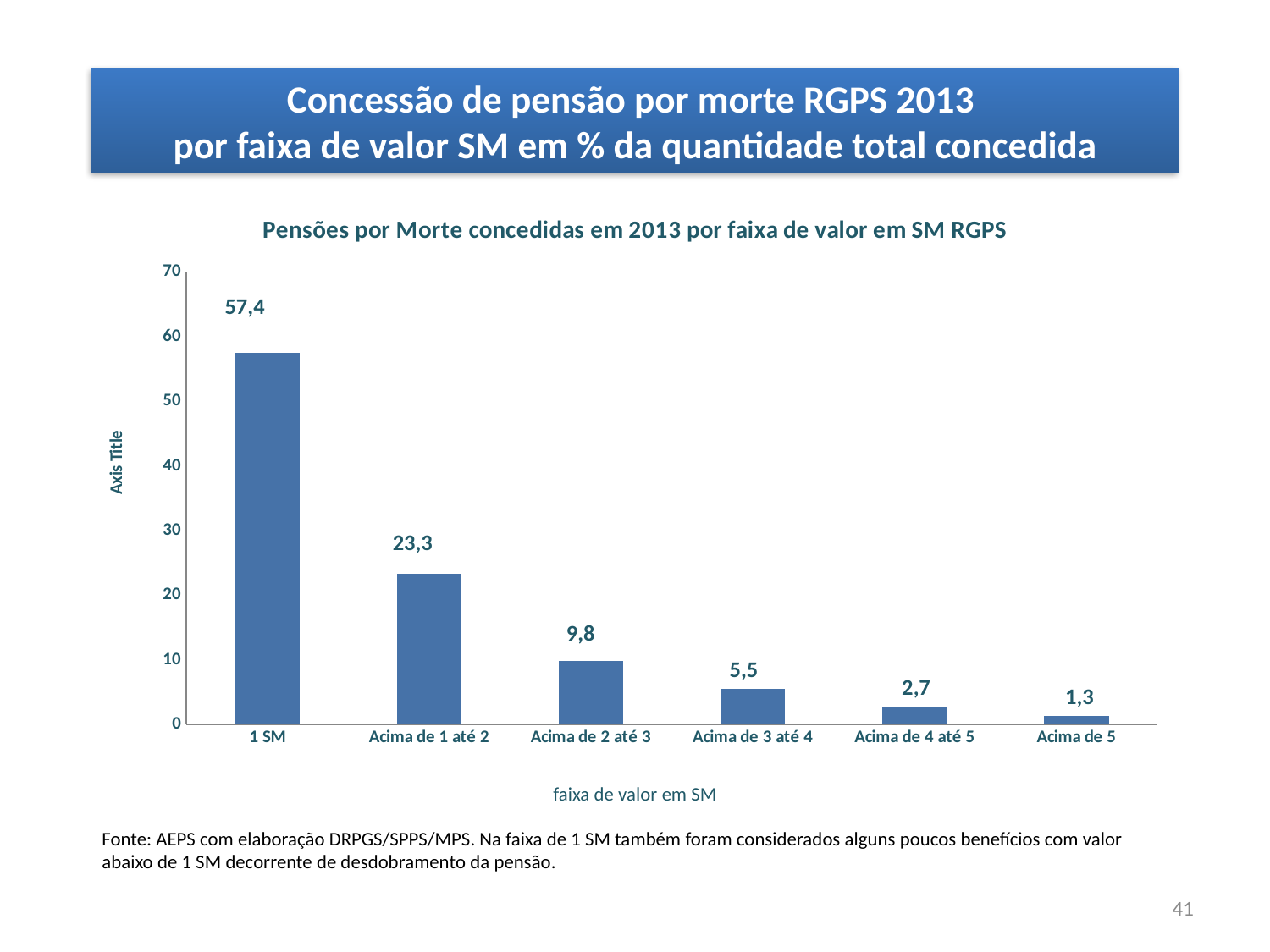
How many categories are shown on the x axis? 6 What is the value for 'Acima de 5'? 1,3 What is the difference between the values for '1 SM' and 'Acima de 1 até 2'? 34,1 What is the value for 'Acima de 2 até 3'? 9,8 Which is larger, the value for 'Acima de 3 até 4' or 'Acima de 4 até 5'? Acima de 3 até 4 Which category has the highest value? 1 SM What is the value for the '1 SM' category? 57,4 Do the values rise or fall from left to right along the x axis? Fall What is the title of the chart? Pensões por Morte concedidas em 2013 por faixa de valor em SM RGPS What kind of chart is shown on the slide? Bar chart Is the value for 'Acima de 1 até 2' greater or less than 20? greater Which category has the lowest value? Acima de 5